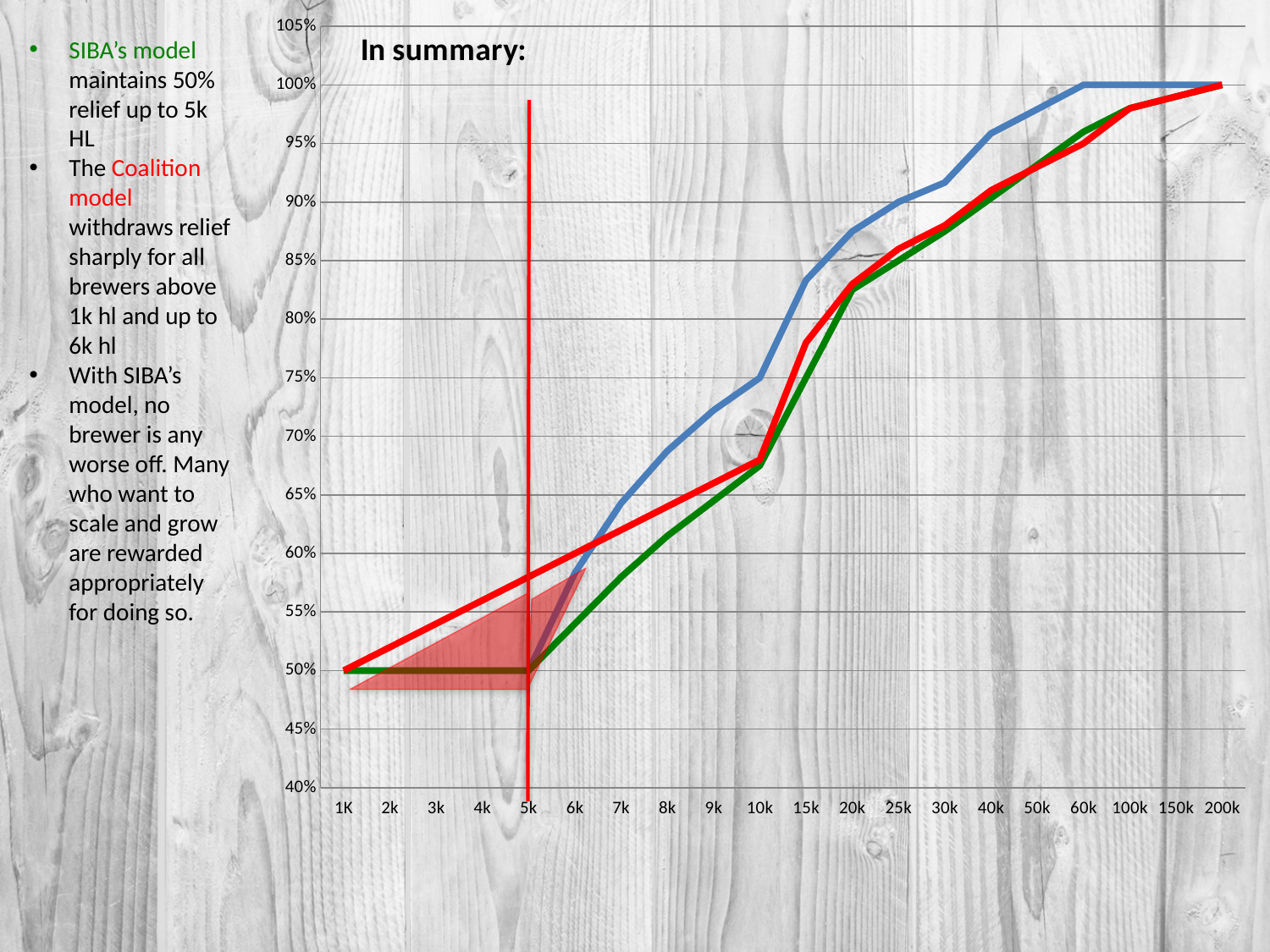
What value do all three lines reach at 200k? 100% What kind of chart is shown on the slide? line chart Do the values of the lines generally rise or fall as you move from 1K to 200k along the x axis? rise What is the difference between the green line's value at 200k and its value at 3k? 50% Is the value of the red line at 5k greater or less than 55%? greater At 3k, which line has the higher value, the red line or the green line? red line How many categories are shown on the x axis of the chart? 20 Is the value of the green line at 10k greater or less than 70%? less What is the value of the green line at 3k? 50% What is the value of the red line at 1K? 50% At 7k, which line has the higher value, the blue line or the green line? blue line Is the value of the blue line at 10k greater or less than 70%? greater